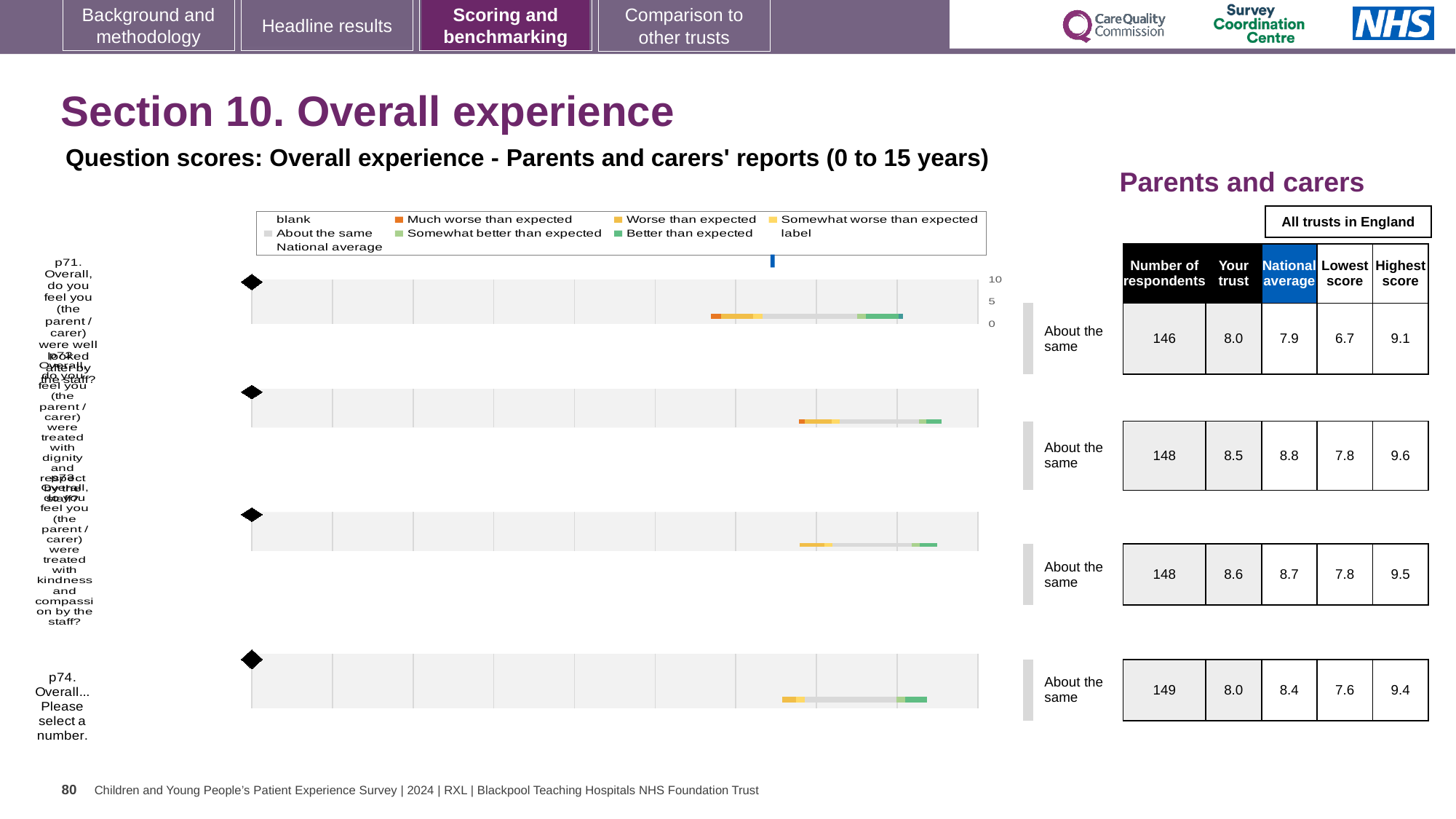
In the table beside the chart, what is the number of respondents for p74? 149 In the table beside the chart, which question row has the highest 'Your trust' score? p73 (8.6) How many entries does the chart legend list? 9 What benchmark category is shown next to each of the four bars? About the same What kind of chart is used to show the question scores on this slide? bar chart In the table beside the chart, is the 'Your trust' score for p74 larger or smaller than its national average? smaller In the table beside the chart, what is the national average for p74 (Overall... Please select a number)? 8.4 Which legend entry is shown in orange? Much worse than expected In the table beside the chart, what is the 'Your trust' score for p71 (Overall, do you feel you were well looked after by the staff)? 8.0 How many question rows (bars) are plotted in the chart? 4 In the table beside the chart, what is the difference between the highest score and the lowest score for p71? 2.4 Which legend entry is shown in dark green? Better than expected